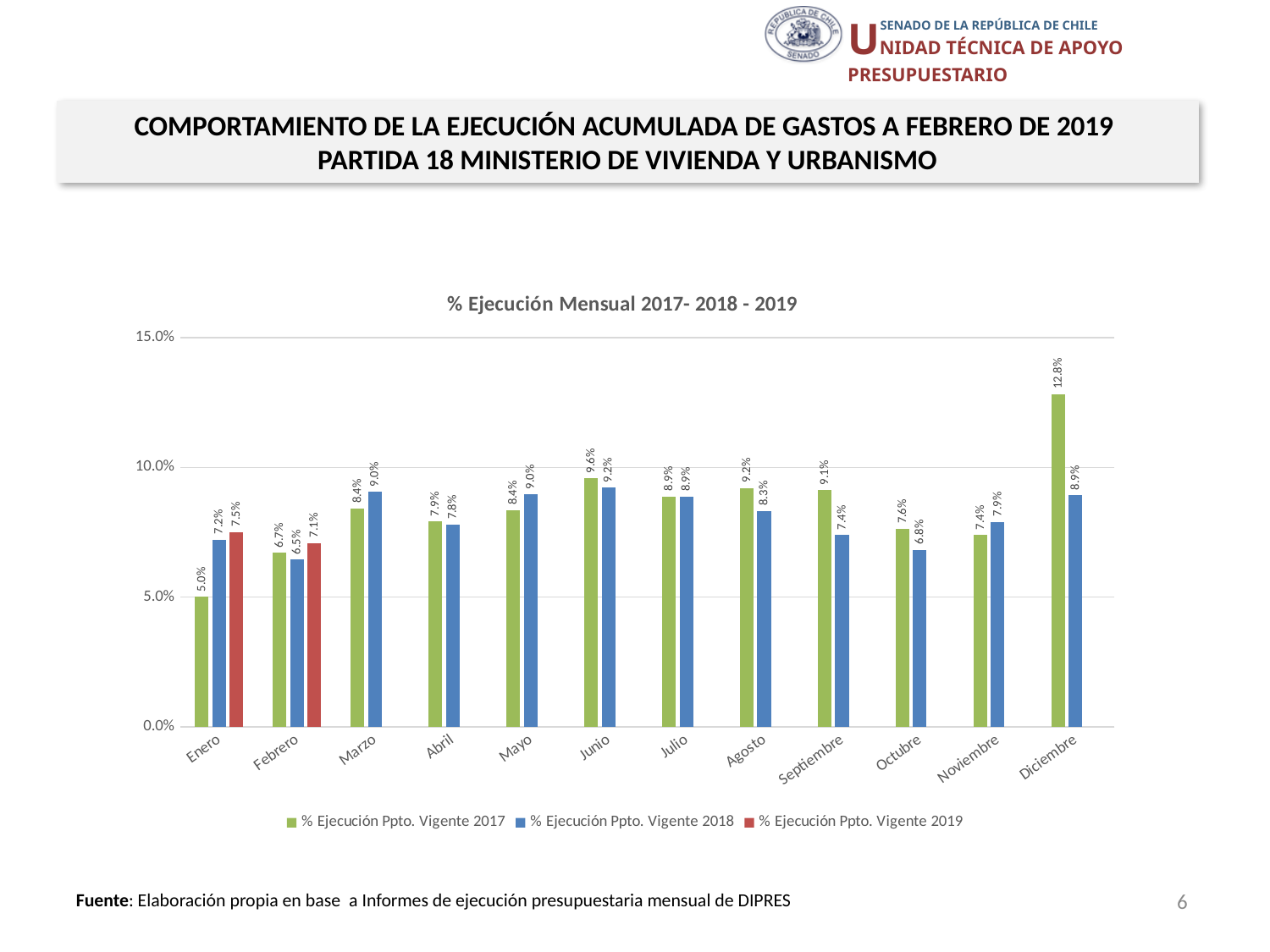
What is the value for % Ejecución Ppto. Vigente 2019 in Enero? 7.5% How many months are shown on the x axis? 12 Is the value for % Ejecución Ppto. Vigente 2017 in Diciembre greater or less than 10.0%? greater Which month has the highest value for % Ejecución Ppto. Vigente 2017? Diciembre Which is larger in Febrero: the 2017 value or the 2019 value? 2019 value (7.1%) What kind of chart is shown on the slide? Bar chart Which month has the lowest value for % Ejecución Ppto. Vigente 2018? Febrero What is the title of the chart? % Ejecución Mensual 2017- 2018 - 2019 How many series does the legend list? 3 What is the difference between the 2017 and 2018 values in Enero? 2.2% What is the value for % Ejecución Ppto. Vigente 2018 in Marzo? 9.0% What is the value for % Ejecución Ppto. Vigente 2017 in Diciembre? 12.8%